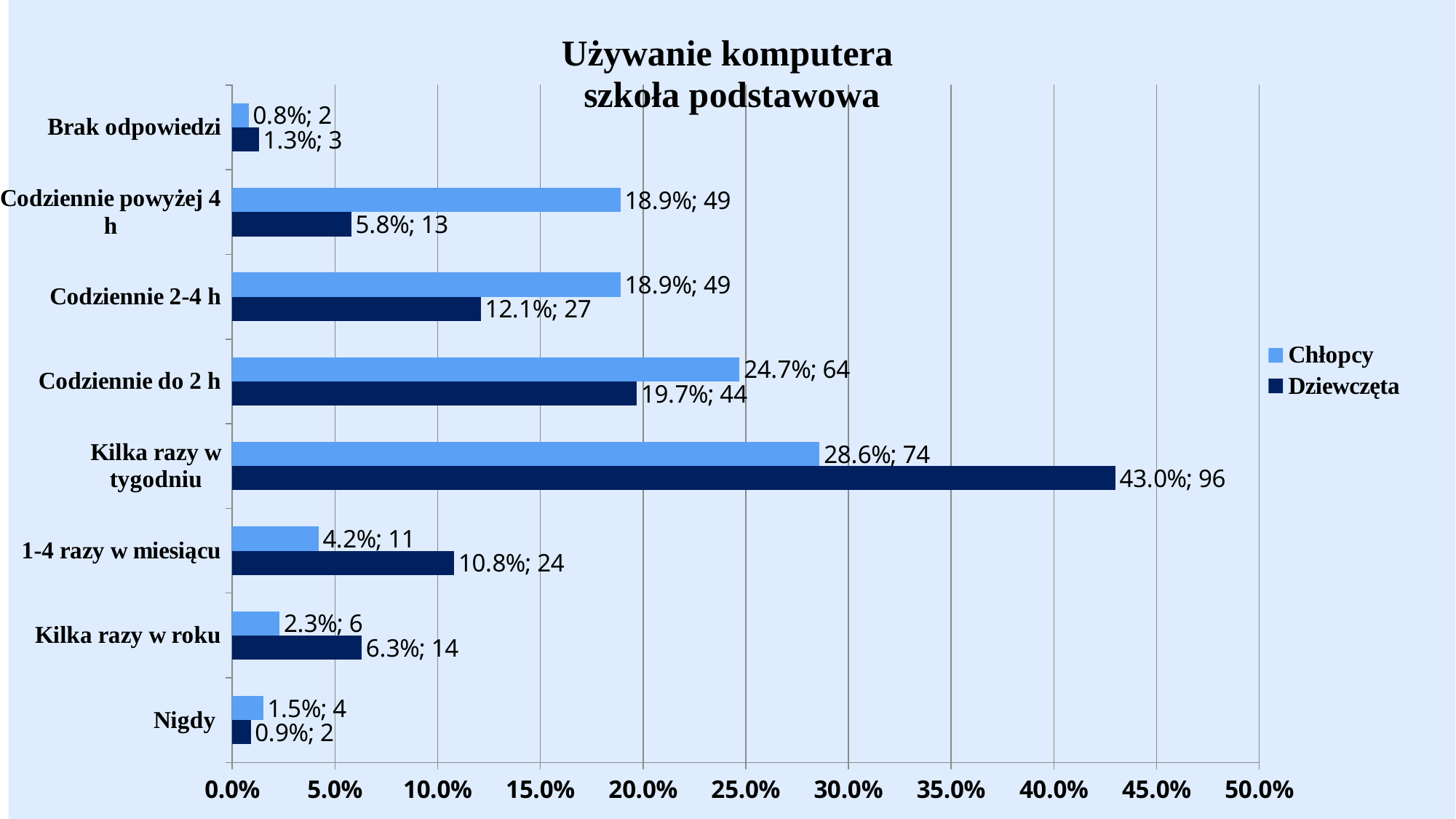
How many Dziewczęta answered 'Kilka razy w tygodniu'? 96 What percentage of Chłopcy use the computer 'Kilka razy w tygodniu'? 28.6% Which category has the highest value for Dziewczęta? Kilka razy w tygodniu What kind of chart is shown on the slide? Bar chart For 'Codziennie powyżej 4 h', which series has the larger value, Chłopcy or Dziewczęta? Chłopcy How many series does the legend list? 2 What percentage of Dziewczęta use the computer 'Codziennie do 2 h'? 19.7% How many categories are shown on the y axis? 8 What is the title of the chart? Używanie komputera szkoła podstawowa Is the value for Dziewczęta in 'Kilka razy w tygodniu' greater or less than 40.0%? greater Which category has the lowest value for Chłopcy? Brak odpowiedzi What is the difference in percentage points between Dziewczęta and Chłopcy for 'Kilka razy w tygodniu'? 14.4